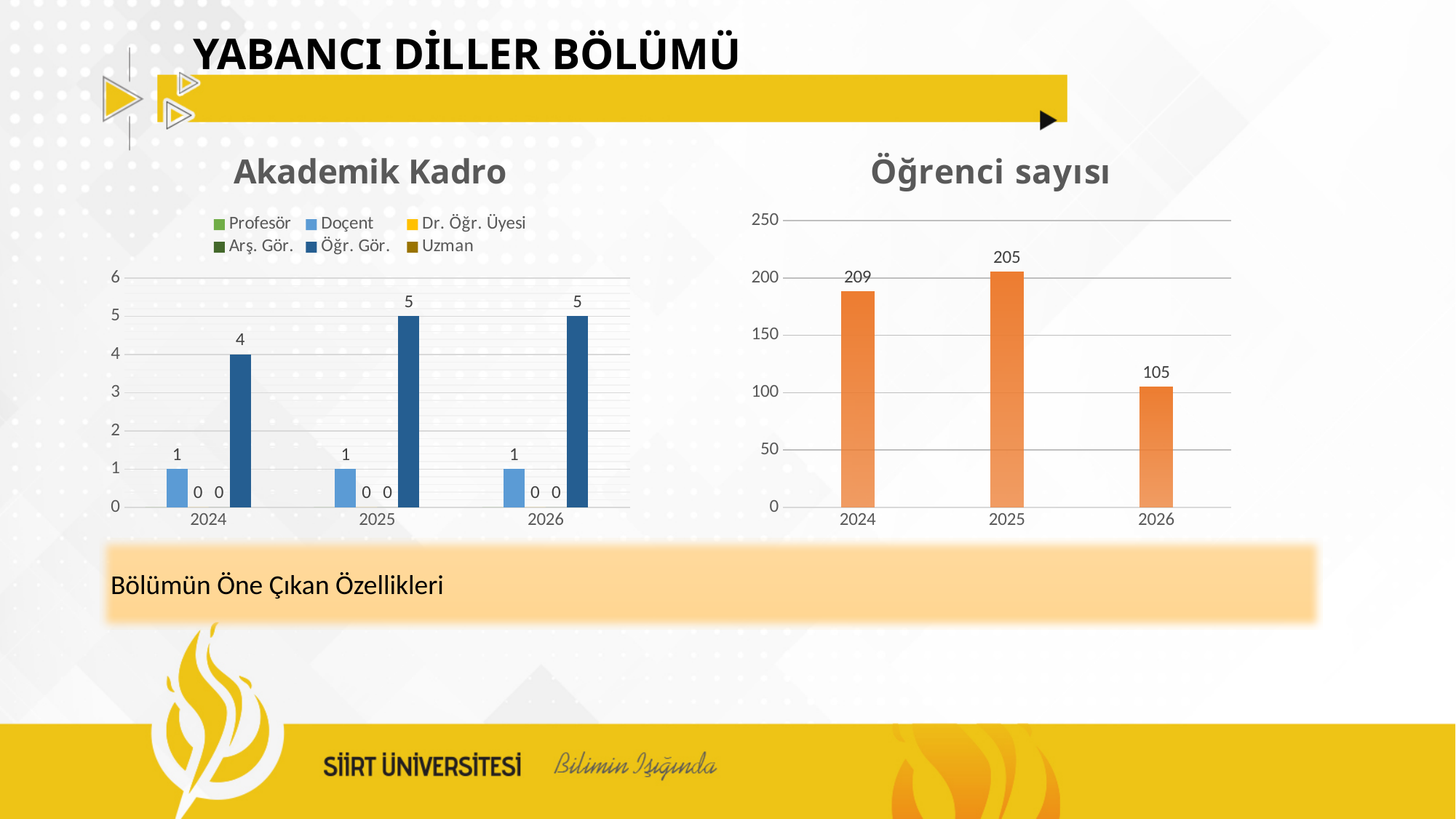
In the Öğrenci sayısı chart, what is the value for 2026? 105 What kind of chart is the Öğrenci sayısı chart? bar chart In the Akademik Kadro chart, what is the value for Öğr. Gör. in 2024? 4 In the Öğrenci sayısı chart, what is the difference between the values for 2025 and 2026? 100 In the Öğrenci sayısı chart, do the values rise or fall from 2025 to 2026? fall In the Öğrenci sayısı chart, what is the value for 2024? 209 In the Öğrenci sayısı chart, how many years are shown on the x axis? 3 In the Akademik Kadro chart, what is the value for Doçent in 2025? 1 In the Öğrenci sayısı chart, which year has the lowest value? 2026 In the Akademik Kadro chart, how many series does the legend list? 6